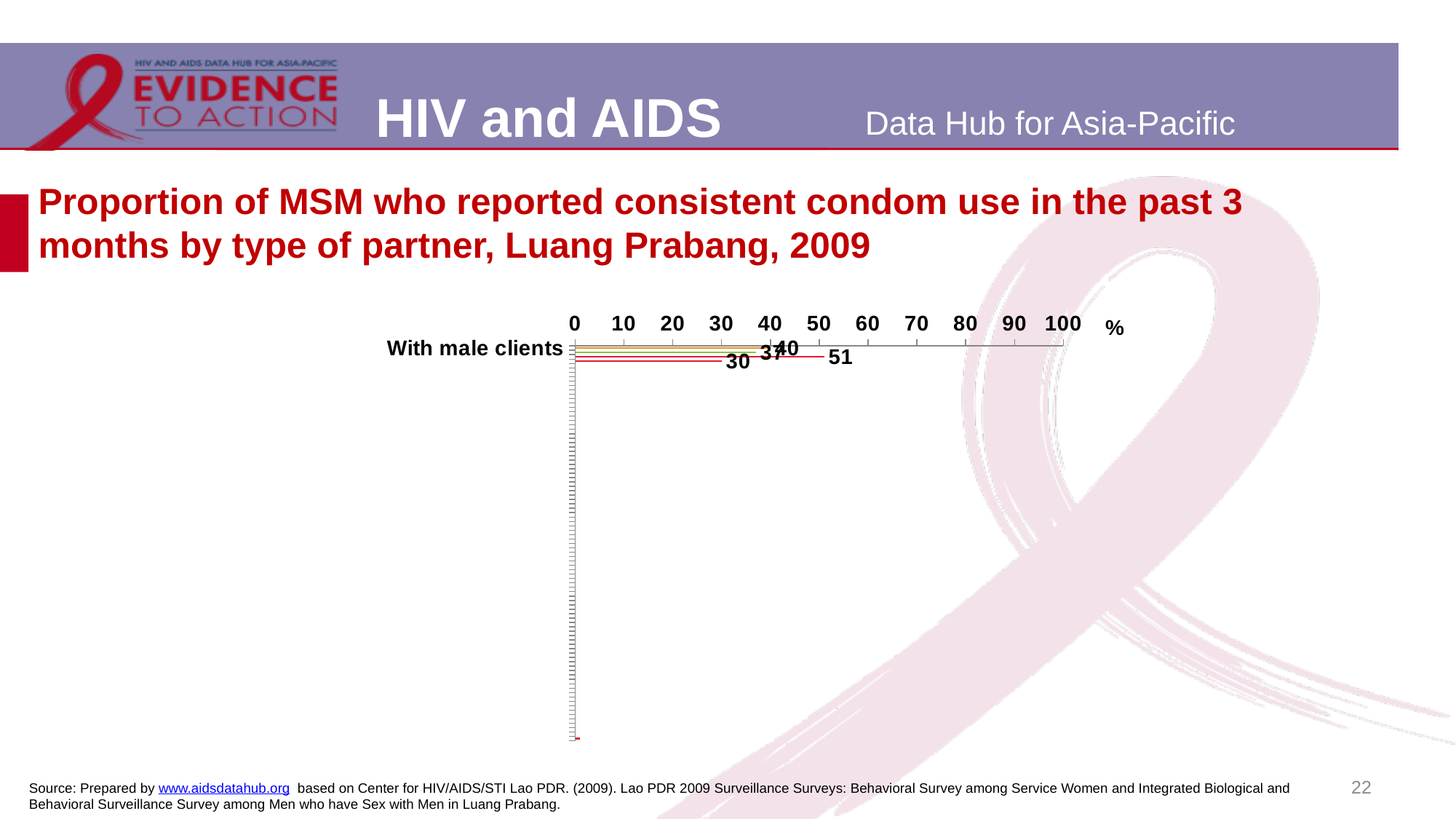
What unit is shown at the end of the horizontal axis of the chart? % How many category labels are readable on the vertical axis of the chart? 1 What is the highest data label printed on the chart? 51 What is the lowest data label printed on the chart? 30 What is the difference between the highest data label (51) and the lowest data label (30) on the chart? 21 What is the category label shown on the vertical axis of the chart? With male clients What kind of chart is shown on the slide? bar chart